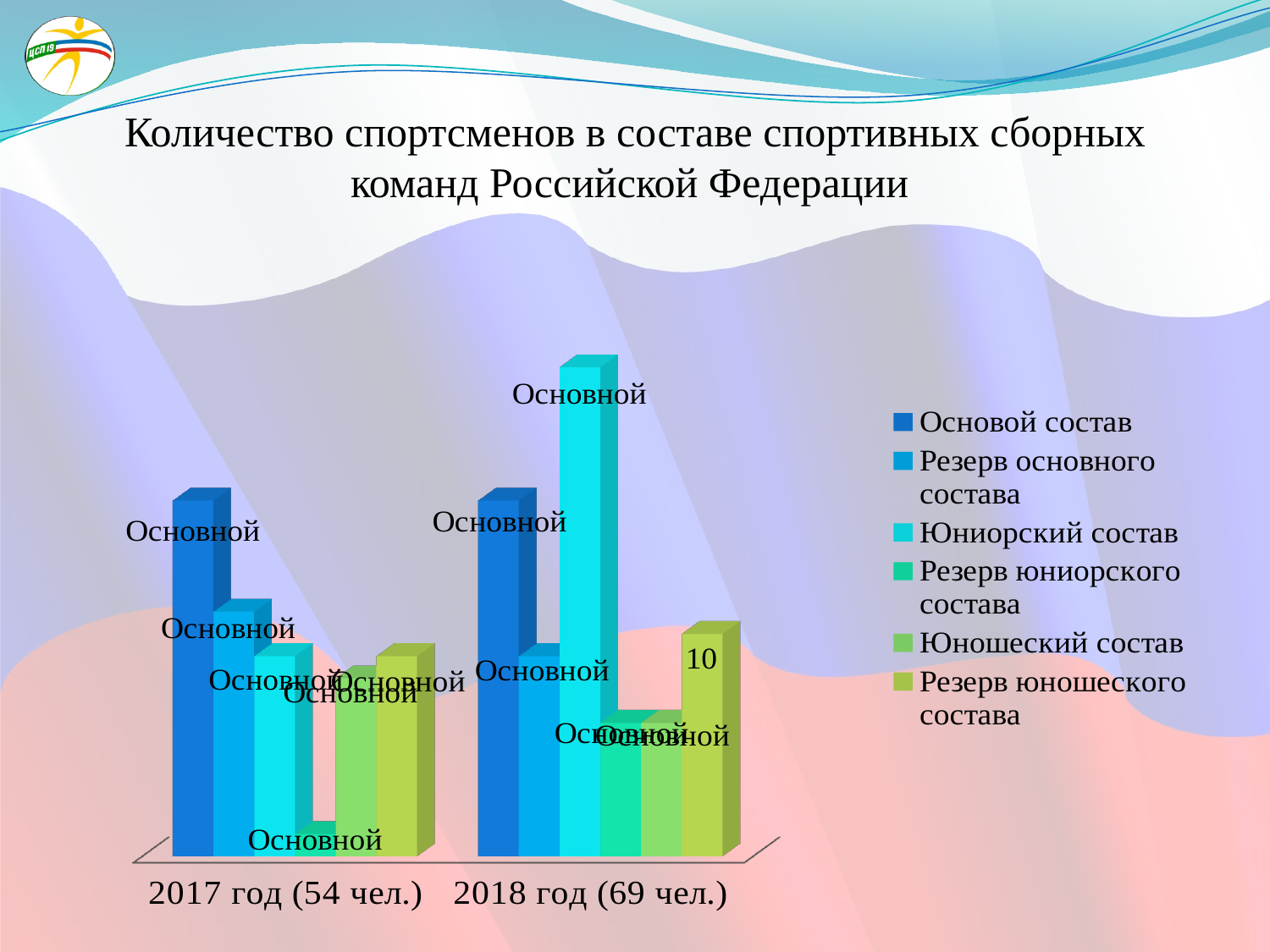
What kind of chart is shown on the slide? bar chart How many series does the chart legend list? 6 In the 2018 год (69 чел.) group, which bar is taller: Юниорский состав or Основой состав? Юниорский состав Is the bar for Юниорский состав taller in 2017 год (54 чел.) or in 2018 год (69 чел.)? 2018 год (69 чел.) In the 2017 год (54 чел.) group, which series has the shortest bar? Резерв юниорского состава In the 2017 год (54 чел.) group, which series has the tallest bar? Основой состав In the 2018 год (69 чел.) group, which series has the tallest bar? Юниорский состав What value is labelled for Резерв юношеского состава in 2018 год (69 чел.)? 10 What is the first entry listed in the chart legend? Основой состав Is the bar for Резерв основного состава taller in 2017 год (54 чел.) or in 2018 год (69 чел.)? 2017 год (54 чел.) What is the title of the chart on the slide? Количество спортсменов в составе спортивных сборных команд Российской Федерации How many categories (years) are shown on the x axis of the chart? 2